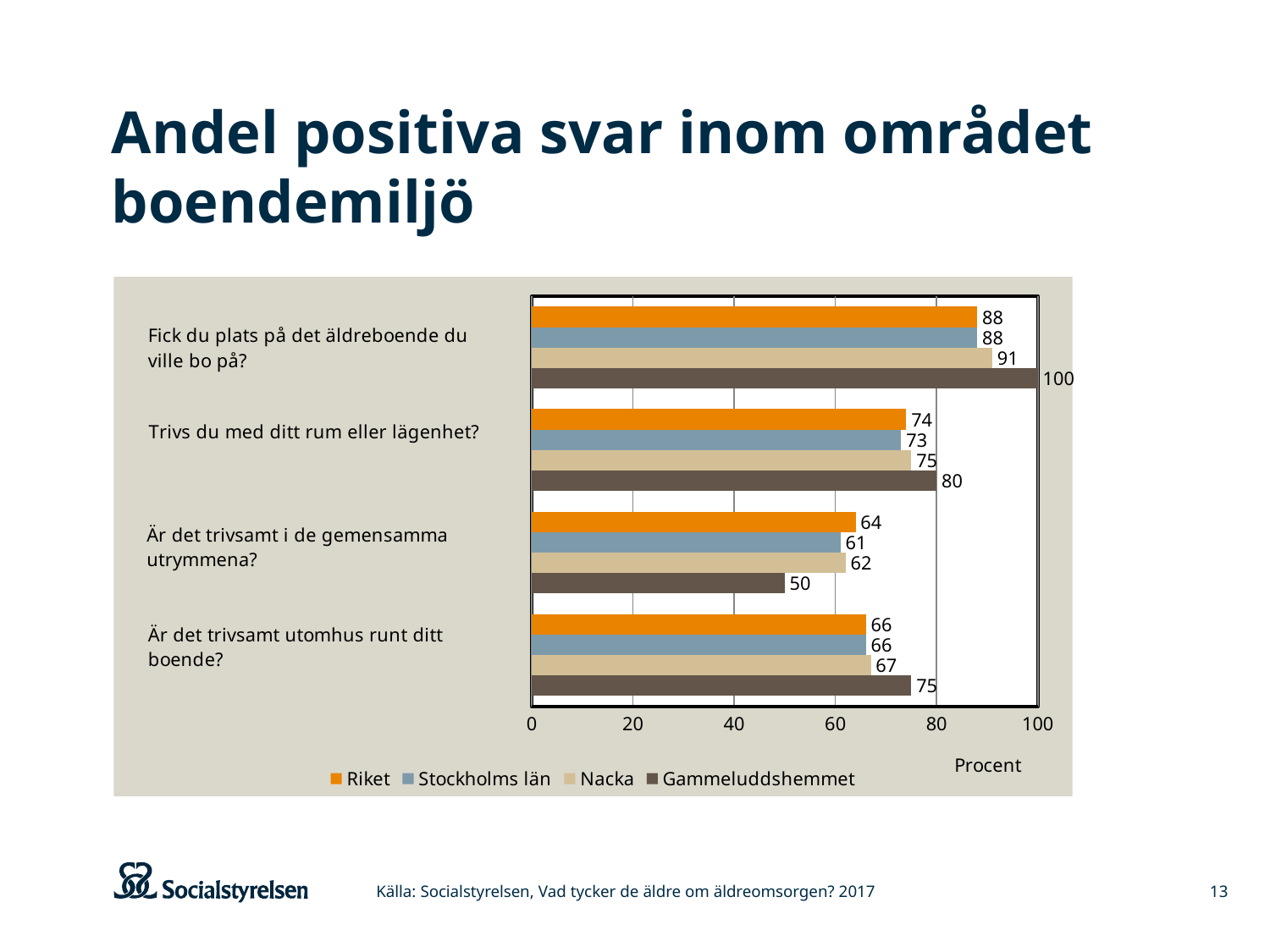
What is the value for Riket on "Är det trivsamt utomhus runt ditt boende?"? 66 What is the value for Stockholms län on "Är det trivsamt i de gemensamma utrymmena?"? 61 What is the label on the horizontal axis of the chart? Procent What is the difference between Gammeluddshemmet and Riket on "Är det trivsamt utomhus runt ditt boende?"? 9 Which series has the highest value on "Trivs du med ditt rum eller lägenhet?"? Gammeluddshemmet What kind of chart is shown on the slide? Bar chart How many series does the legend list? 4 How many question categories are shown on the chart? 4 What is the value for Nacka on "Trivs du med ditt rum eller lägenhet?"? 75 Which is larger for Gammeluddshemmet: "Trivs du med ditt rum eller lägenhet?" or "Är det trivsamt i de gemensamma utrymmena?"? Trivs du med ditt rum eller lägenhet? Which series has the lowest value on "Är det trivsamt i de gemensamma utrymmena?"? Gammeluddshemmet What is the value for Gammeluddshemmet on "Fick du plats på det äldreboende du ville bo på?"? 100